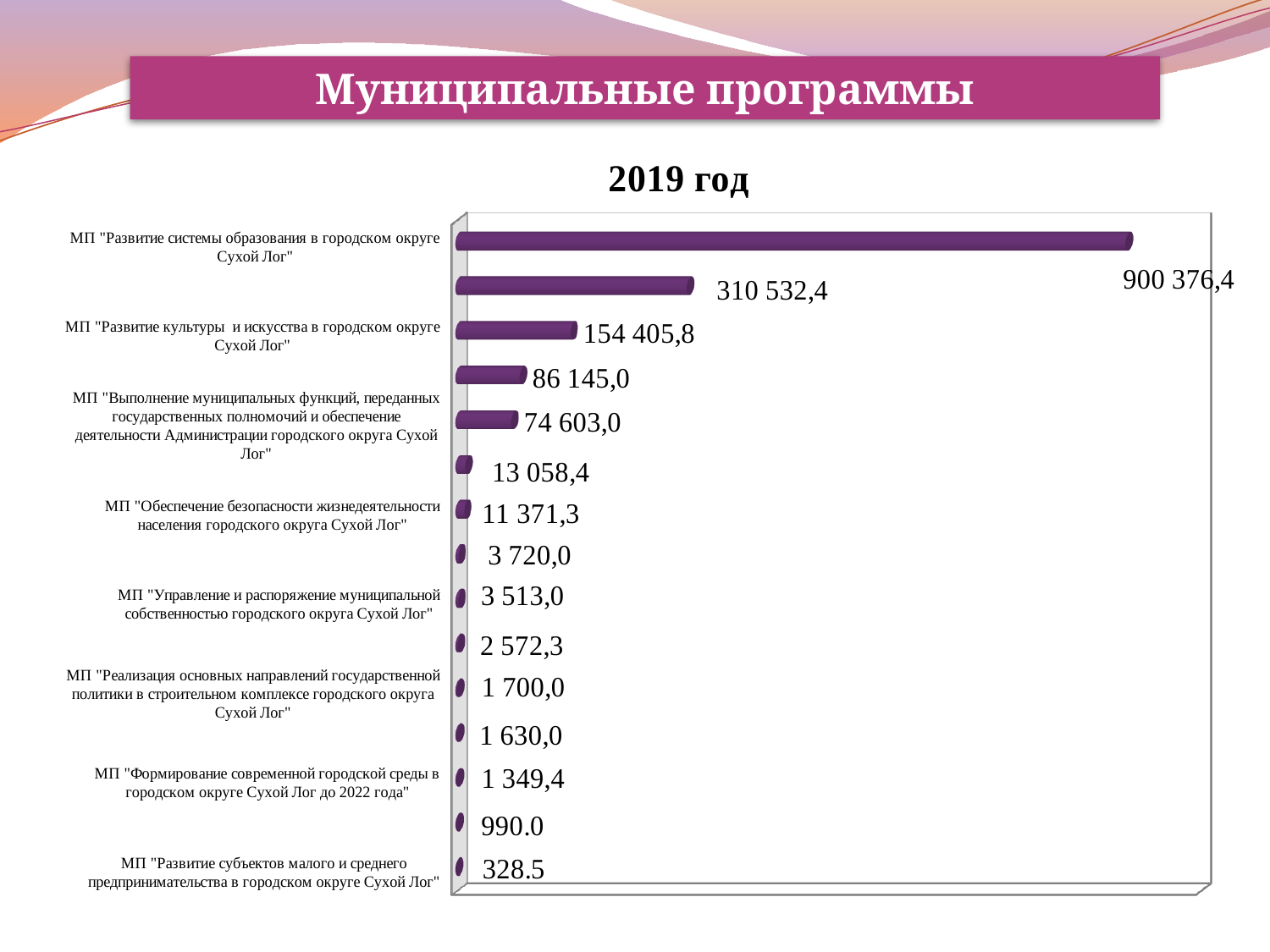
Which program has the highest value? МП "Развитие системы образования в городском округе Сухой Лог" What kind of chart is shown on the slide? bar chart Which program has the lowest value? МП "Развитие субъектов малого и среднего предпринимательства в городском округе Сухой Лог" Which is larger: the value for МП "Развитие культуры и искусства" or МП "Выполнение муниципальных функций, переданных государственных полномочий"? МП "Развитие культуры и искусства" How many bars are plotted in the chart? 15 What is the title of the chart? 2019 год What is the value for МП "Развитие культуры и искусства в городском округе Сухой Лог"? 154 405,8 What is the value for МП "Развитие субъектов малого и среднего предпринимательства в городском округе Сухой Лог"? 328.5 What is the difference between the values for МП "Развитие системы образования" and МП "Развитие культуры и искусства"? 745 970,6 What is the value for МП "Формирование современной городской среды в городском округе Сухой Лог до 2022 года"? 1 349,4 Do the bar values increase or decrease going from the top of the chart to the bottom? decrease What is the value for МП "Развитие системы образования в городском округе Сухой Лог"? 900 376,4